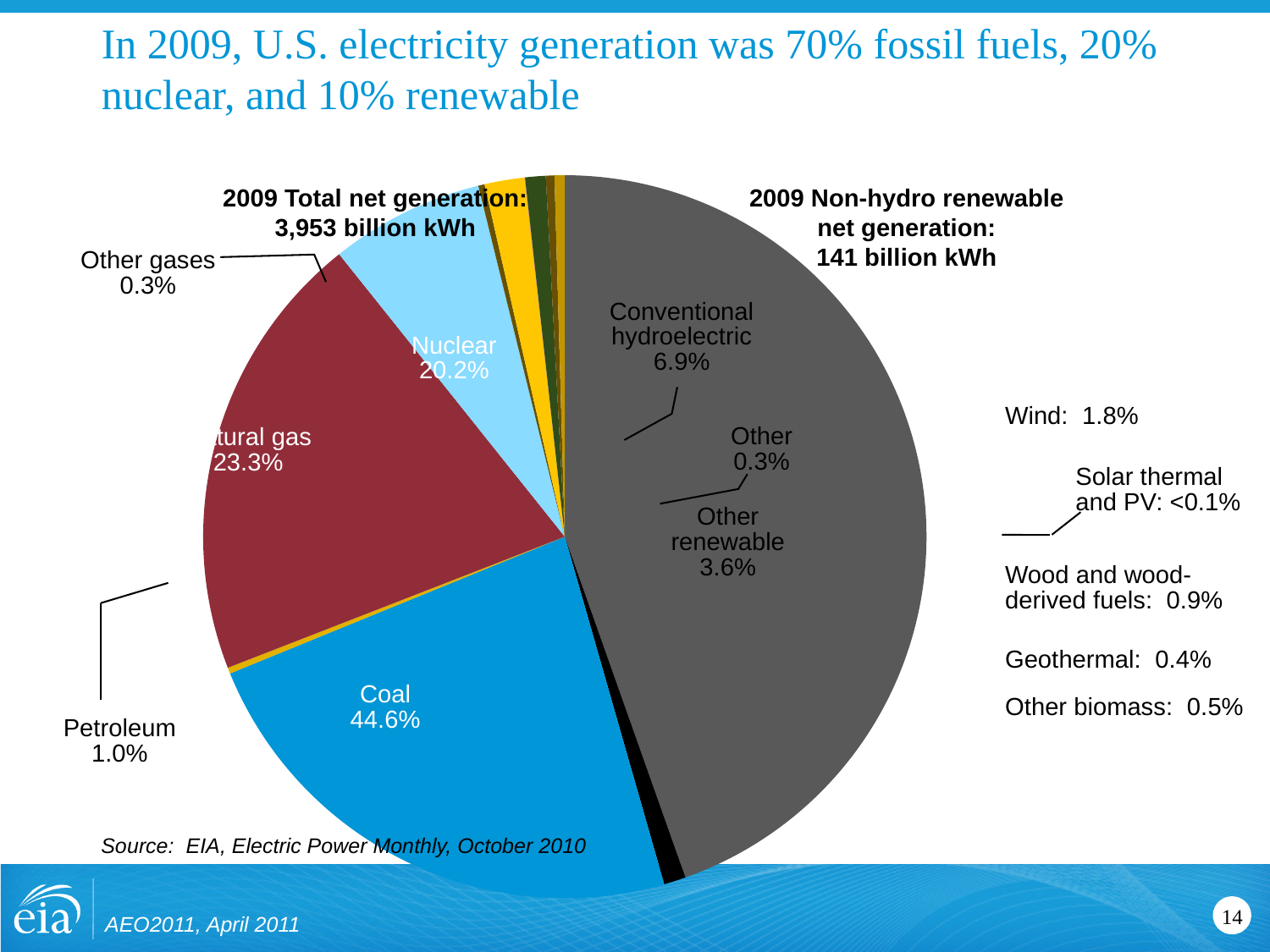
What share of 2009 U.S. electricity generation came from nuclear? 20.2% What kind of chart is shown on the slide? Pie chart Which fuel source has the largest share of 2009 U.S. electricity generation? Coal Which has the larger share, wood and wood-derived fuels or geothermal? Wood and wood-derived fuels Which has the larger share of 2009 generation, nuclear or natural gas? Natural gas What share of 2009 U.S. electricity generation came from conventional hydroelectric? 6.9% How many percentage points larger is the nuclear share than the conventional hydroelectric share? 13.3% What share of 2009 U.S. electricity generation came from natural gas? 23.3% What share of 2009 U.S. electricity generation came from wind? 1.8% How many percentage points larger is the coal share than the natural gas share? 21.3% What share of 2009 U.S. electricity generation came from coal? 44.6% What was the 2009 total net generation stated on the chart? 3,953 billion kWh